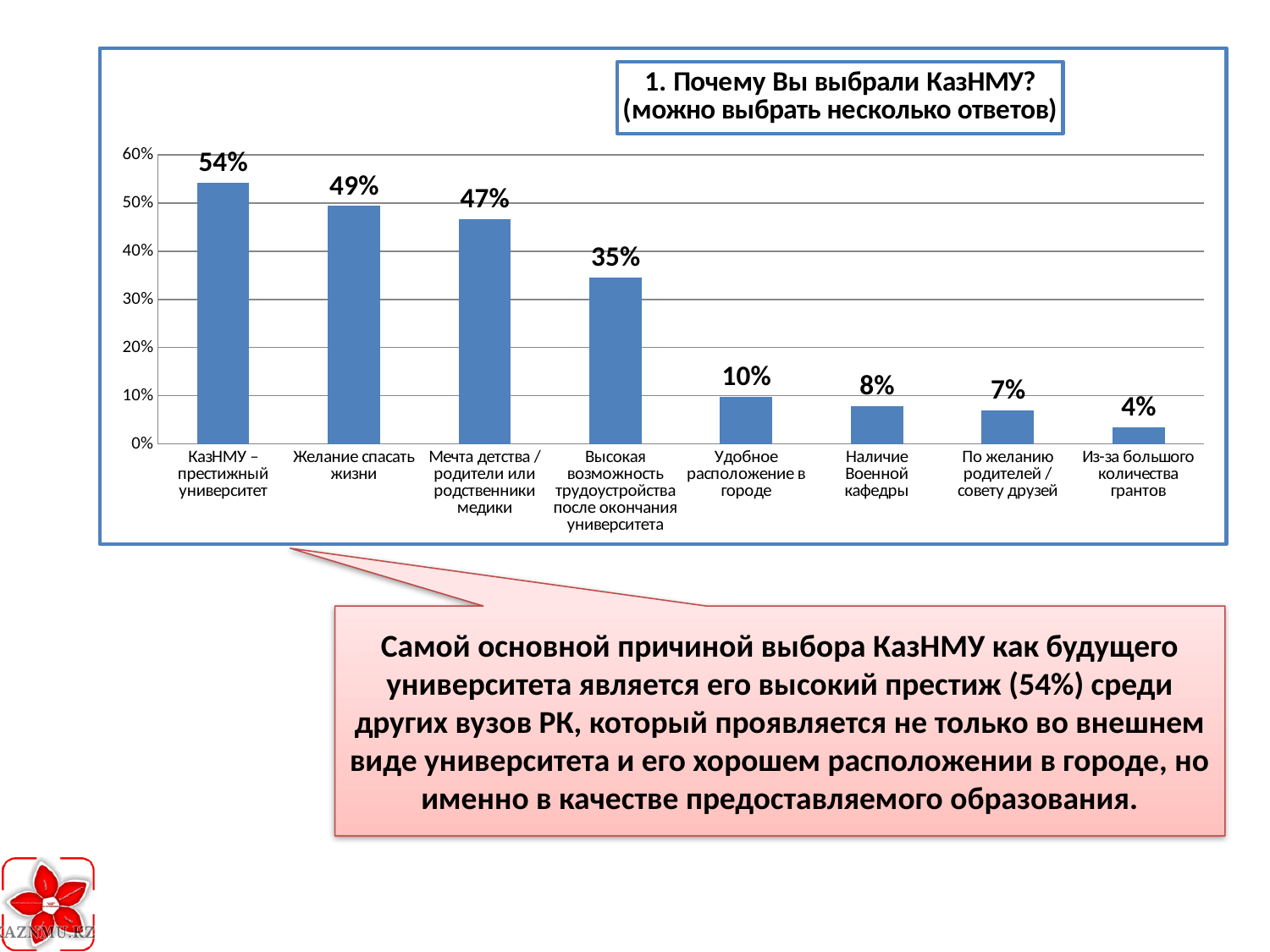
What is the value for "Удобное расположение в городе"? 10% Which reason has the highest percentage? КазНМУ – престижный университет How many reasons (categories) are shown in the chart? 8 What type of chart is shown on the slide? bar chart Is the value for "По желанию родителей / совету друзей" greater or less than 10%? less What is the value for "Наличие Военной кафедры"? 8% Which is larger: the value for "Высокая возможность трудоустройства после окончания университета" or for "Удобное расположение в городе"? Высокая возможность трудоустройства после окончания университета What is the title of the chart? 1. Почему Вы выбрали КазНМУ? (можно выбрать несколько ответов) What is the difference between the values for "Желание спасать жизни" and "Мечта детства / родители или родственники медики"? 2% What percentage of respondents chose "КазНМУ – престижный университет" as a reason? 54% Which reason has the lowest percentage? Из-за большого количества грантов What is the value for "Желание спасать жизни"? 49%